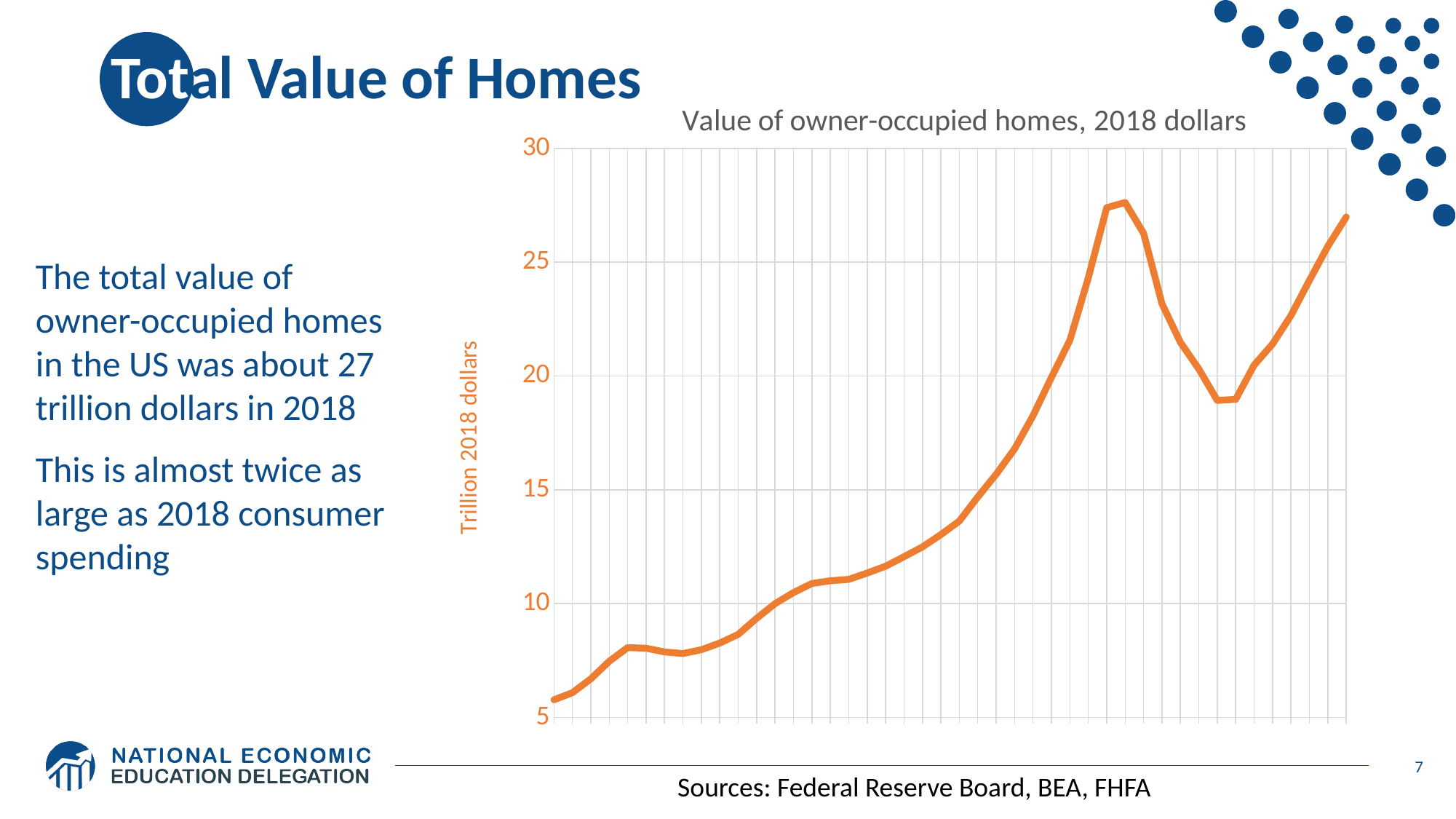
Is the value at the right end of the line greater or less than 25? greater What is the title of the chart? Value of owner-occupied homes, 2018 dollars Which is larger, the value at the left end of the line or the value at the bottom of the dip after the peak? the bottom of the dip after the peak Overall, does the line rise or fall from the left end of the chart to the right end? rise What kind of chart is shown on the slide? line chart What is the highest value shown on the vertical axis? 30 Is the lowest point of the dip that follows the peak greater or less than 20? less Is the highest point of the line greater or less than 25? greater Which is larger, the value at the peak of the line or the value at the right end of the line? the peak What is the label on the vertical axis of the chart? Trillion 2018 dollars